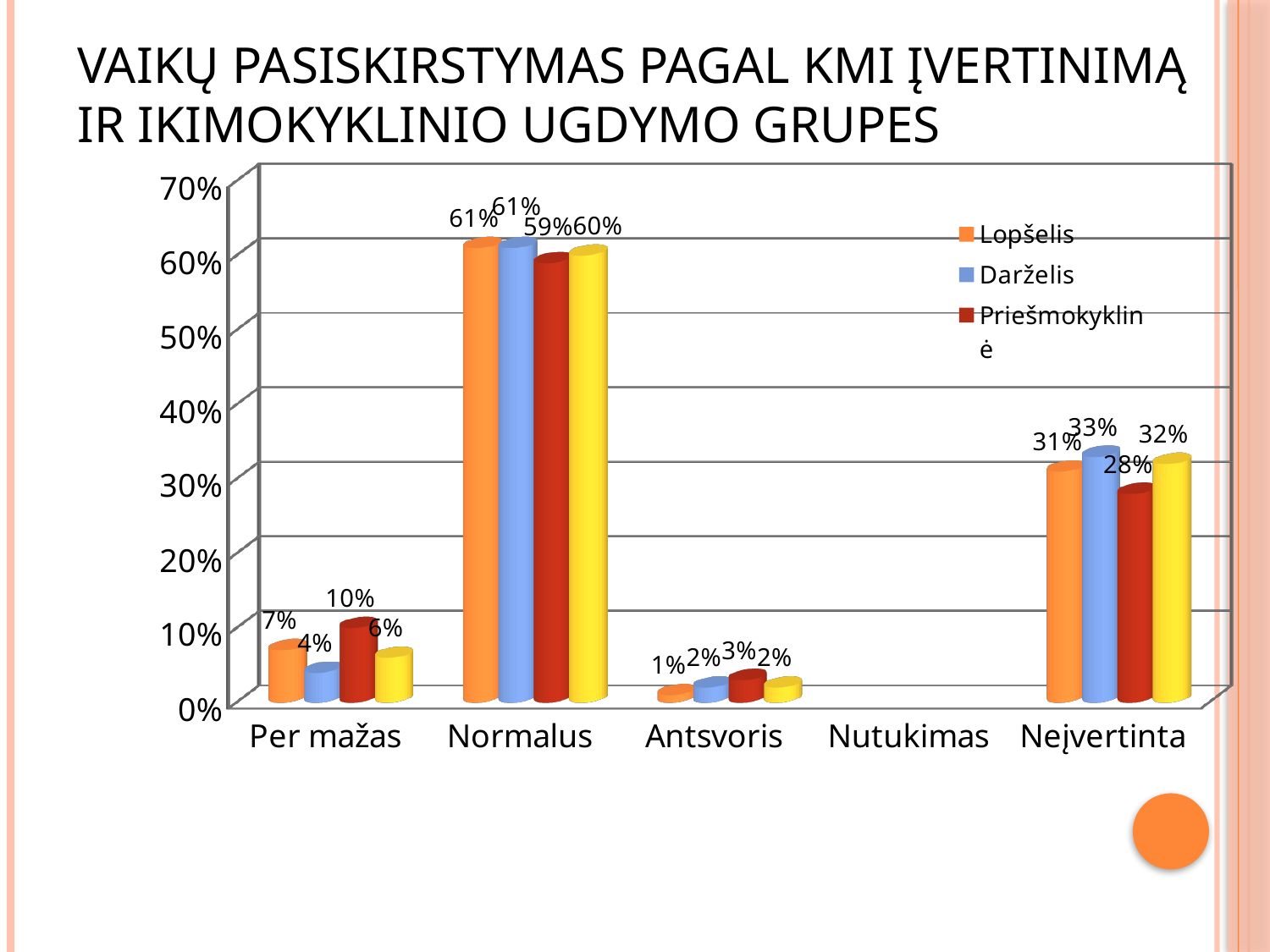
In the Neįvertinta category, which is larger: the Darželis value or the Priešmokyklinė value? Darželis What is the difference between the Priešmokyklinė and Darželis values in the Per mažas category? 6 percentage points Which series has the highest value in the Per mažas category? Priešmokyklinė What is the value for Lopšelis in the Per mažas category? 7% What kind of chart is shown on the slide? Bar chart What is the value for Darželis in the Neįvertinta category? 33% What colour represents the Darželis series? Blue Which category has the highest value for the Lopšelis series? Normalus What is the value for Priešmokyklinė in the Antsvoris category? 3% How many series does the legend list? 3 What is the value for Priešmokyklinė in the Normalus category? 59% How many categories are shown on the x axis? 5